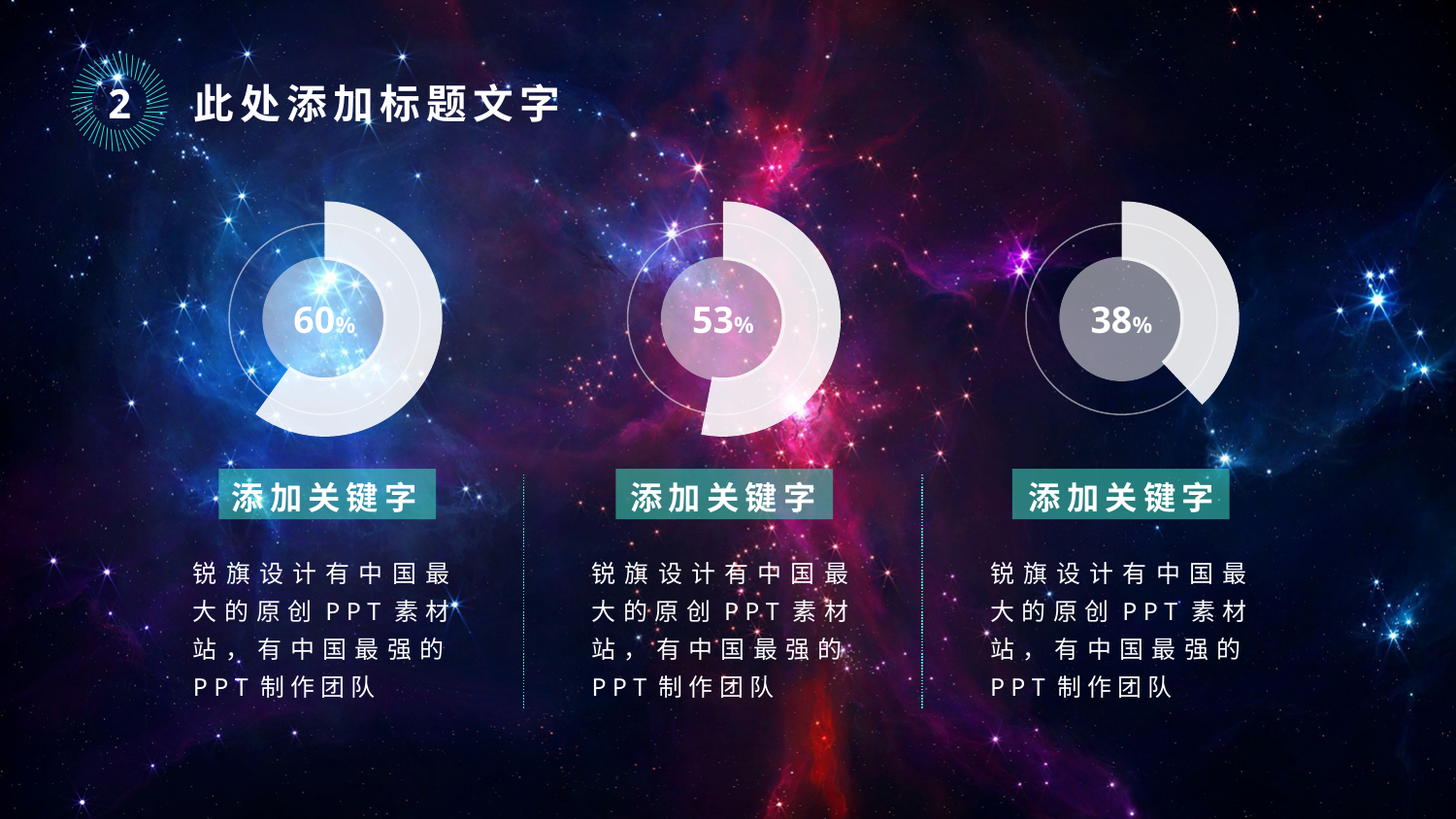
Which is larger, the percentage in the middle chart or the percentage in the right chart? The middle chart (53%) Which of the three donut charts shows the lowest percentage? The right chart (38%) What percentage is shown in the right donut chart? 38% What kind of chart is used to display the percentages on this slide? Donut chart What is the difference between the percentage in the left chart and the percentage in the middle chart? 7% Is the percentage in the right chart greater or less than 50%? less What percentage is shown in the middle donut chart? 53% How many donut charts are on the slide? 3 Which of the three donut charts shows the highest percentage? The left chart (60%) What percentage is shown in the left donut chart? 60% What is the difference between the percentage in the left chart and the percentage in the right chart? 22% What is the title text at the top of the slide? 此处添加标题文字